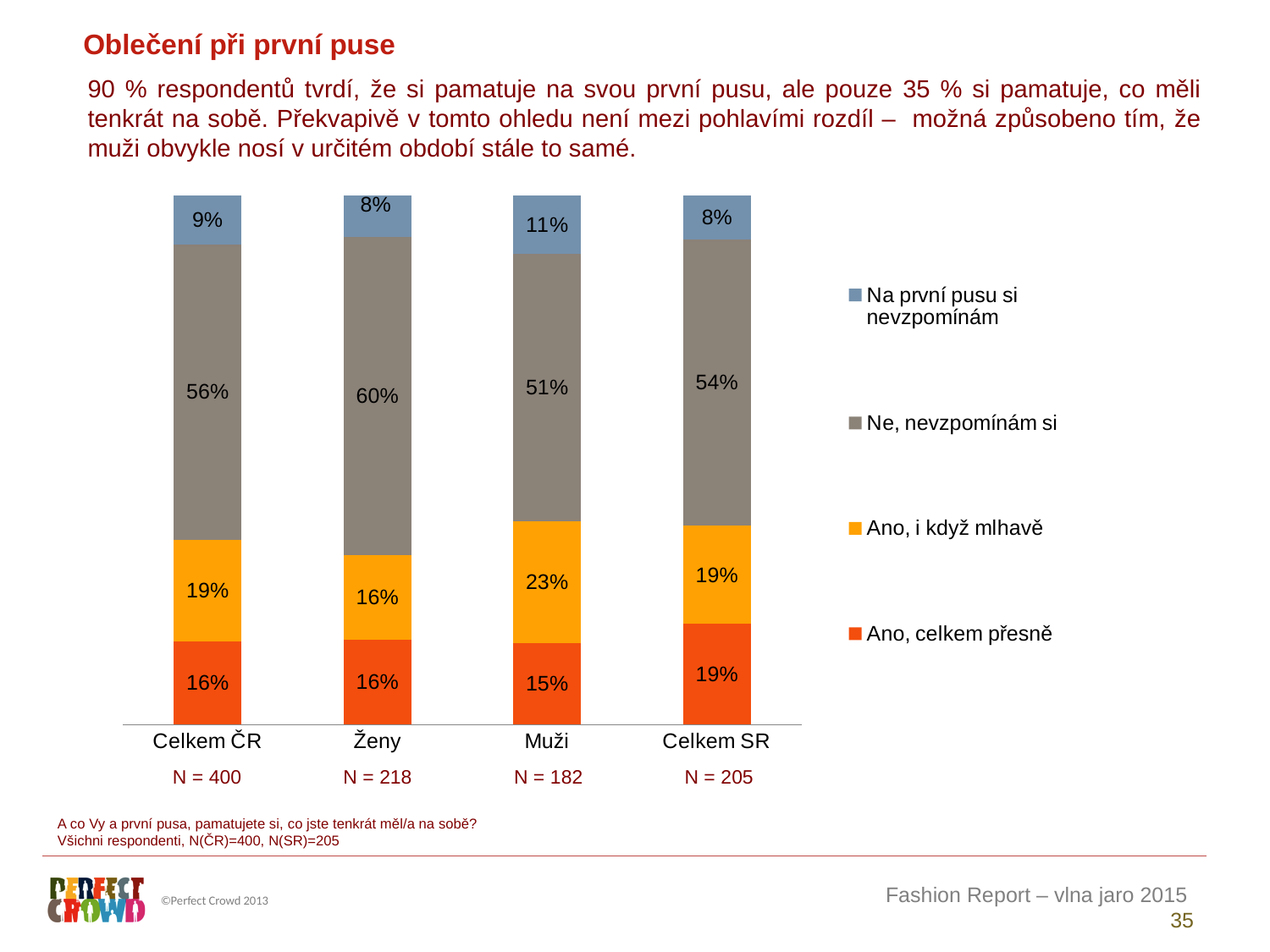
How many categories are shown on the x axis of the chart? 4 What is the value of "Na první pusu si nevzpomínám" for Celkem ČR? 9% What is the value of "Ano, i když mlhavě" for Muži? 23% What is the value of "Ano, celkem přesně" for Celkem SR? 19% What is the difference between the "Ne, nevzpomínám si" values for Ženy and Muži? 9% What type of chart is shown on the slide? Stacked bar chart How many series does the chart legend list? 4 Which category has the lowest value for "Ano, celkem přesně"? Muži Which is larger: the "Ano, i když mlhavě" value for Muži or for Ženy? Muži What is the value of "Ne, nevzpomínám si" for Ženy? 60% What is the sample size (N) shown under the Muži bar? N = 182 Which category has the highest value for "Ne, nevzpomínám si"? Ženy